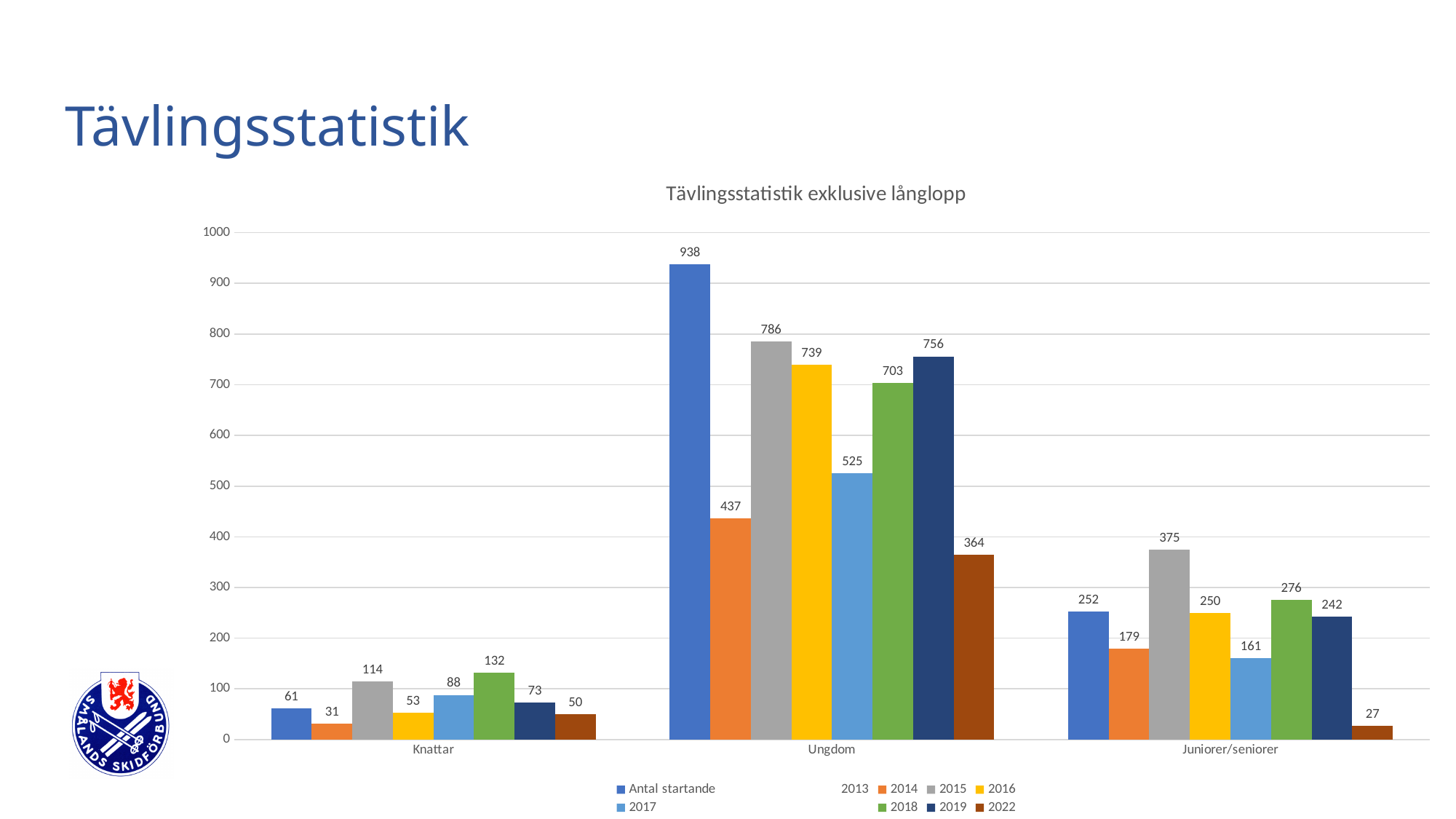
What is the value for Knattar in the 2018 series? 132 Which category has the highest value in the 2019 series? Ungdom What is the value for Ungdom in the 2015 series? 786 Which category has the lowest value in the 2014 series? Knattar What is the value for Juniorer/seniorer in the 2022 series? 27 Is the 2017 value for Ungdom greater or less than 500? greater What is the difference between the 2015 and 2022 values for Ungdom? 422 What type of chart is shown on the slide? Bar chart Which is larger for Juniorer/seniorer: the 2016 value or the 2018 value? 2018 Which series has the highest value for Knattar? 2018 What is the title of the chart? Tävlingsstatistik exklusive långlopp How many categories are shown on the x axis of the chart? 3